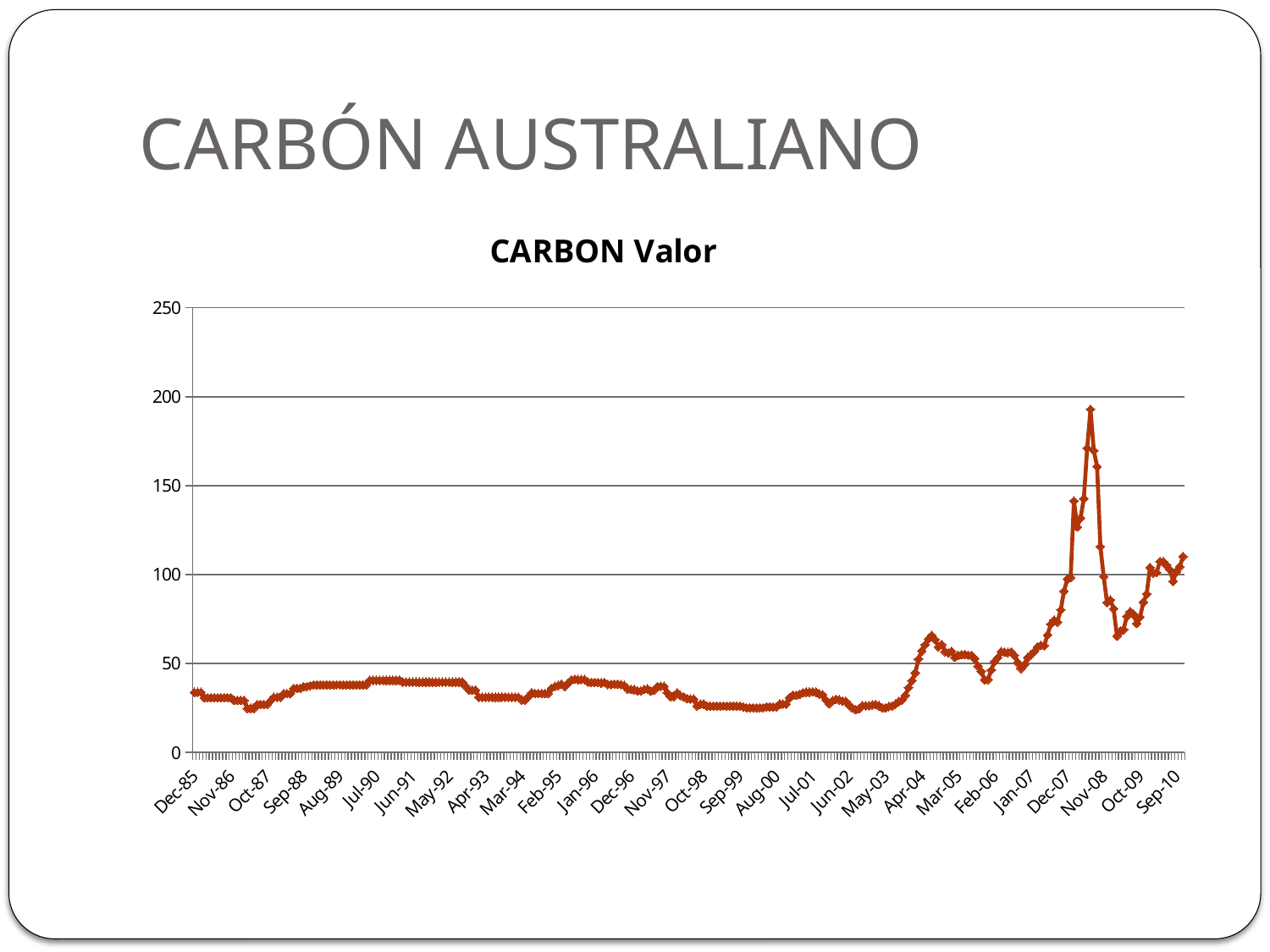
Overall, do the values rise or fall from Dec-85 to Sep-10? rise Is the value for Jul-90 greater or less than 100? less Which has the larger value, Dec-85 or Sep-10? Sep-10 Is the highest value on the chart greater or less than 200? less Is the value for Jan-07 greater or less than 100? less What is the maximum value shown on the vertical axis? 250 What kind of chart is shown on the slide? line chart What is the title of the chart? CARBON Valor